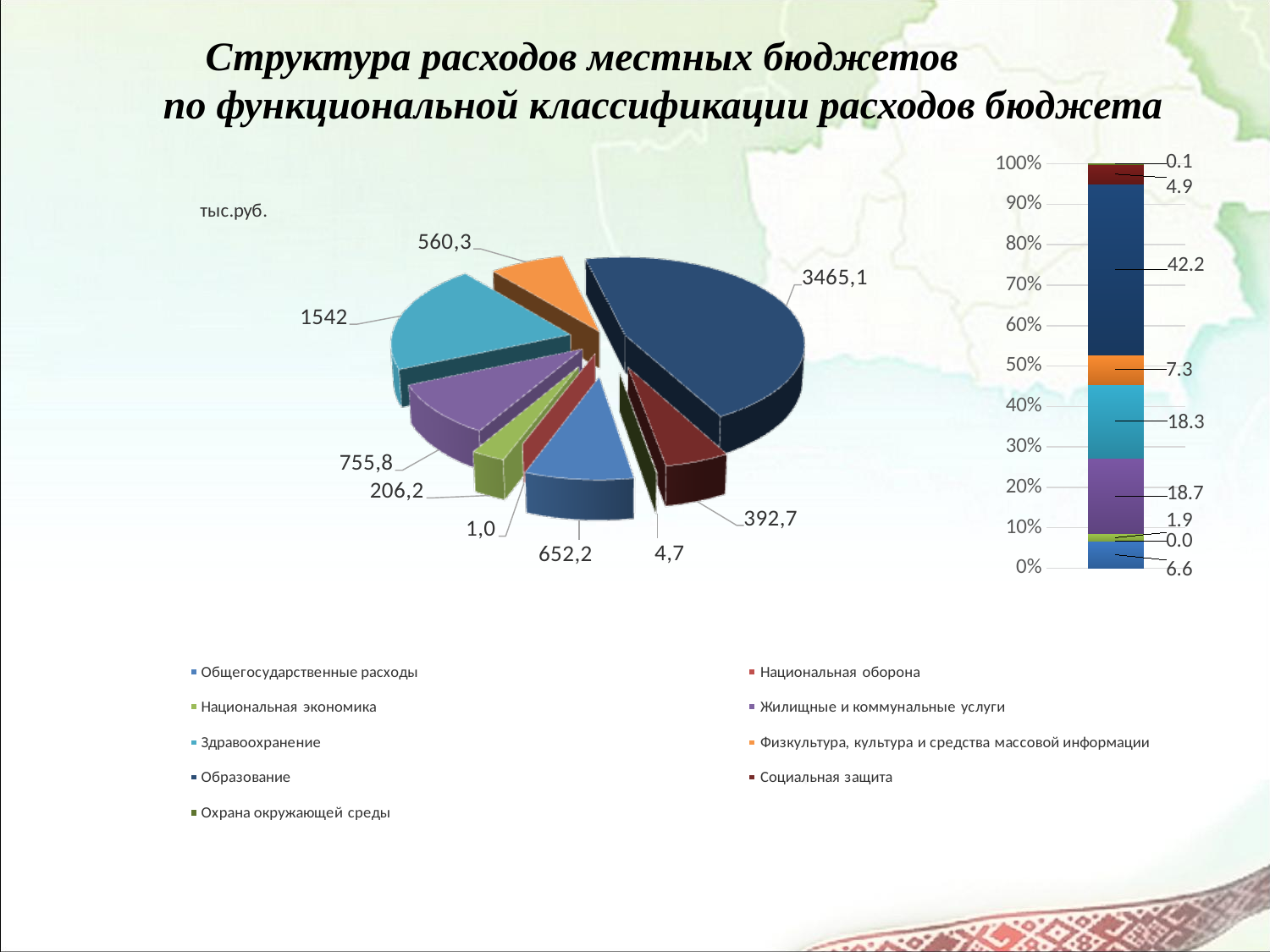
In the stacked bar chart on the right, what is the value for Здравоохранение (the cyan segment)? 18.3 In the stacked bar chart on the right, what is the value of the largest segment? 42.2 What kind of chart is the chart on the left of the slide? pie chart In the pie chart on the left, which is larger: the slice labelled 652,2 or the slice labelled 560,3? 652,2 In the pie chart on the left, what is the difference between the slice labelled 1542 and the slice labelled 755,8? 786,2 How many categories does the legend list? 9 In the pie chart on the left, what is the value for Образование (the dark blue slice)? 3465,1 What kind of chart is the chart on the right of the slide? bar chart In the pie chart on the left, what is the value of the smallest slice? 1,0 In the pie chart on the left, what is the value of the largest slice? 3465,1 What unit is shown next to the pie chart on the left? тыс.руб. How many slices does the pie chart on the left have? 9